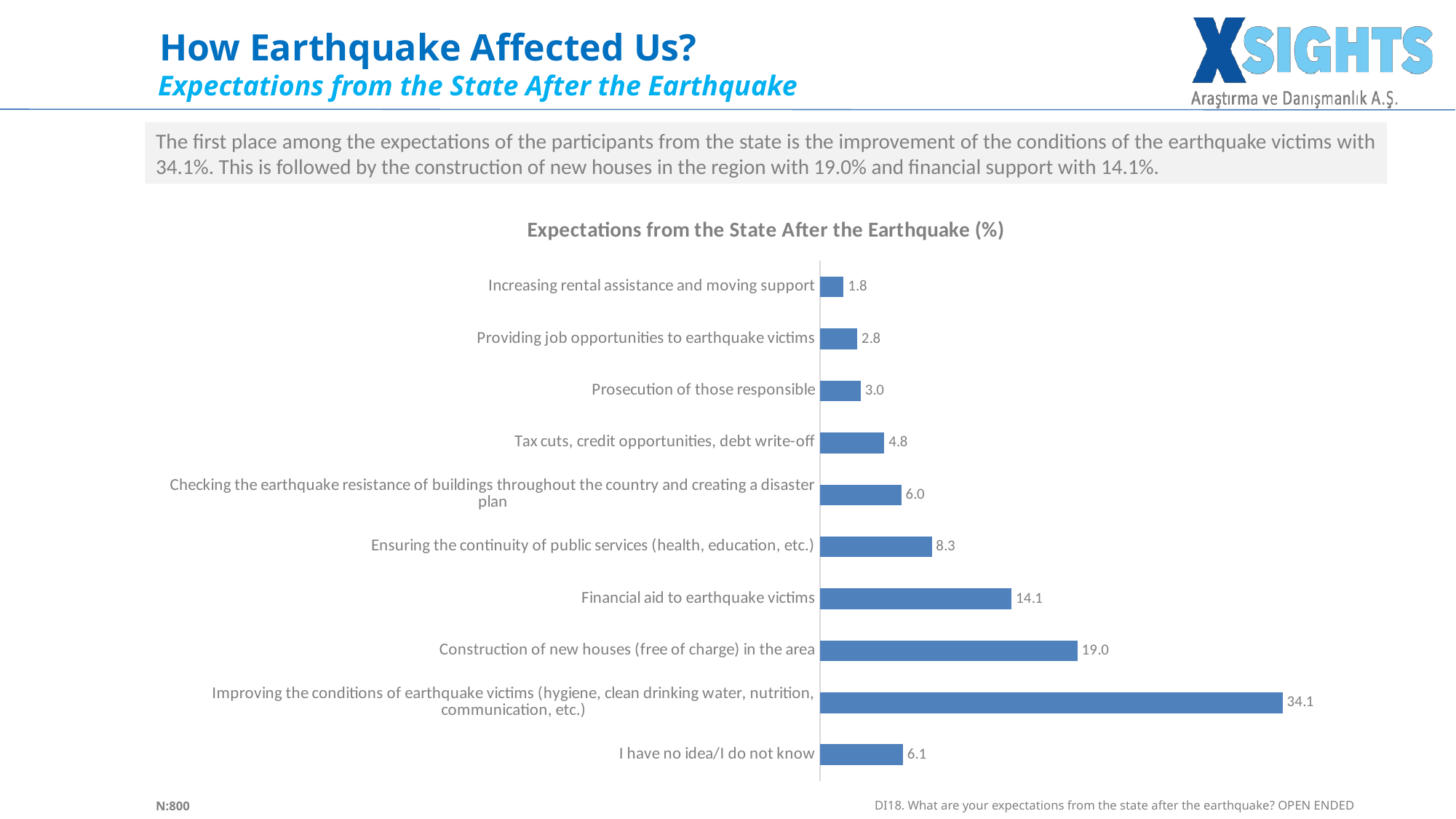
Which category has the highest value? Improving the conditions of earthquake victims (hygiene, clean drinking water, nutrition, communication, etc.) What is the difference between the values for 'Providing job opportunities to earthquake victims' and 'Increasing rental assistance and moving support'? 1.0 What is the value for 'I have no idea/I do not know'? 6.1 What is the title of the chart? Expectations from the State After the Earthquake (%) What is the sample size (N) shown on the slide? 800 Which category has the lowest value? Increasing rental assistance and moving support How many categories are shown in the chart? 10 What is the value for 'Financial aid to earthquake victims'? 14.1 What is the value for 'Prosecution of those responsible'? 3.0 Which is larger: the value for 'Ensuring the continuity of public services (health, education, etc.)' or the value for 'Tax cuts, credit opportunities, debt write-off'? Ensuring the continuity of public services (health, education, etc.) What is the difference between the values for 'Construction of new houses (free of charge) in the area' and 'Financial aid to earthquake victims'? 4.9 What kind of chart is shown on the slide? Bar chart